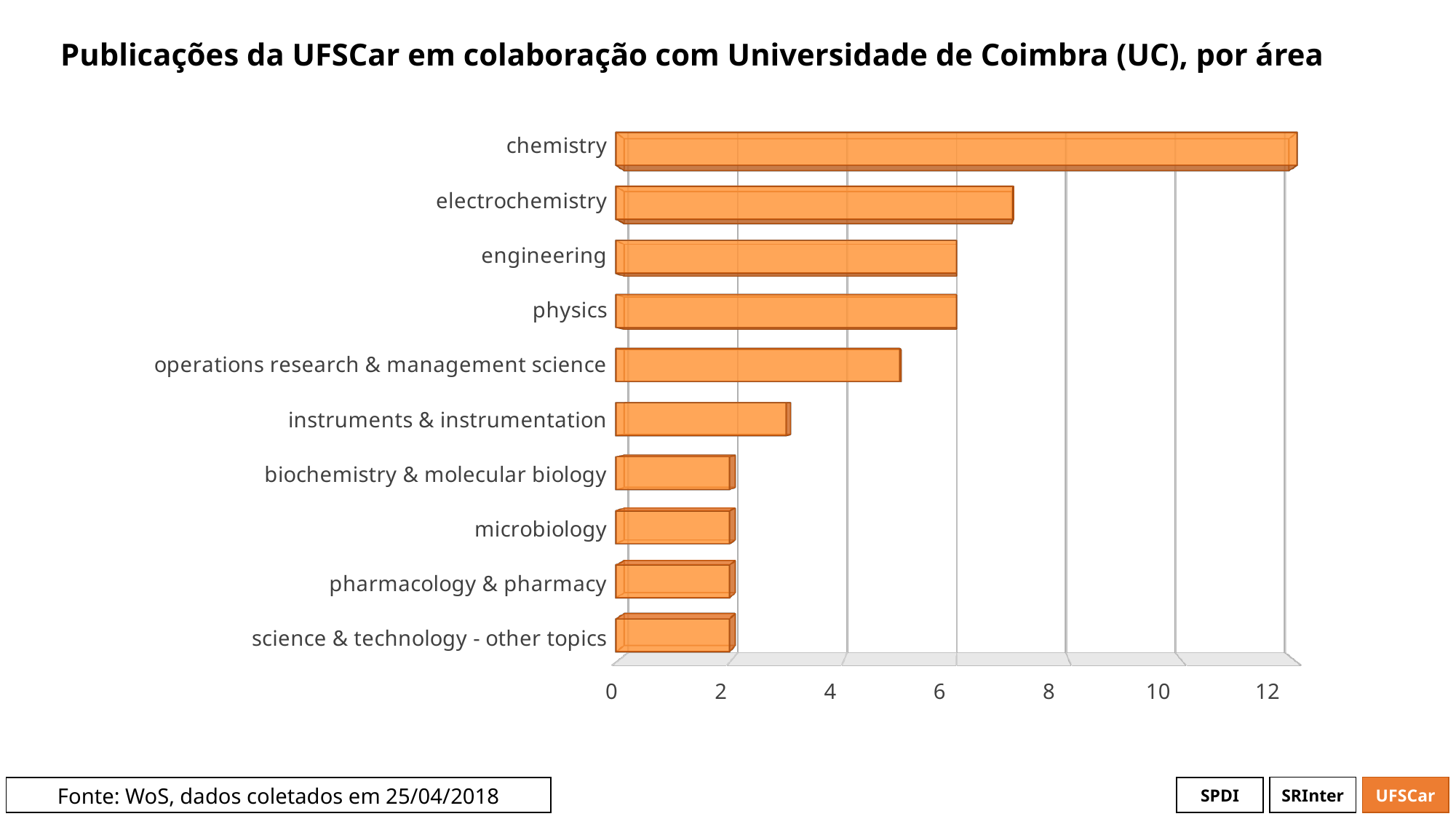
Which has more publications, chemistry or electrochemistry? chemistry Is the value for biochemistry & molecular biology greater or less than 4? less Which area has the highest number of publications? chemistry Is the value for electrochemistry greater or less than 6? greater What kind of chart is shown on the slide? bar chart Going from the top bar to the bottom bar, do the values increase or decrease? decrease Is the value for operations research & management science greater or less than 4? greater How many areas (categories) are plotted in the chart? 10 What is the title of the chart? Publicações da UFSCar em colaboração com Universidade de Coimbra (UC), por área Which has more publications, electrochemistry or physics? electrochemistry